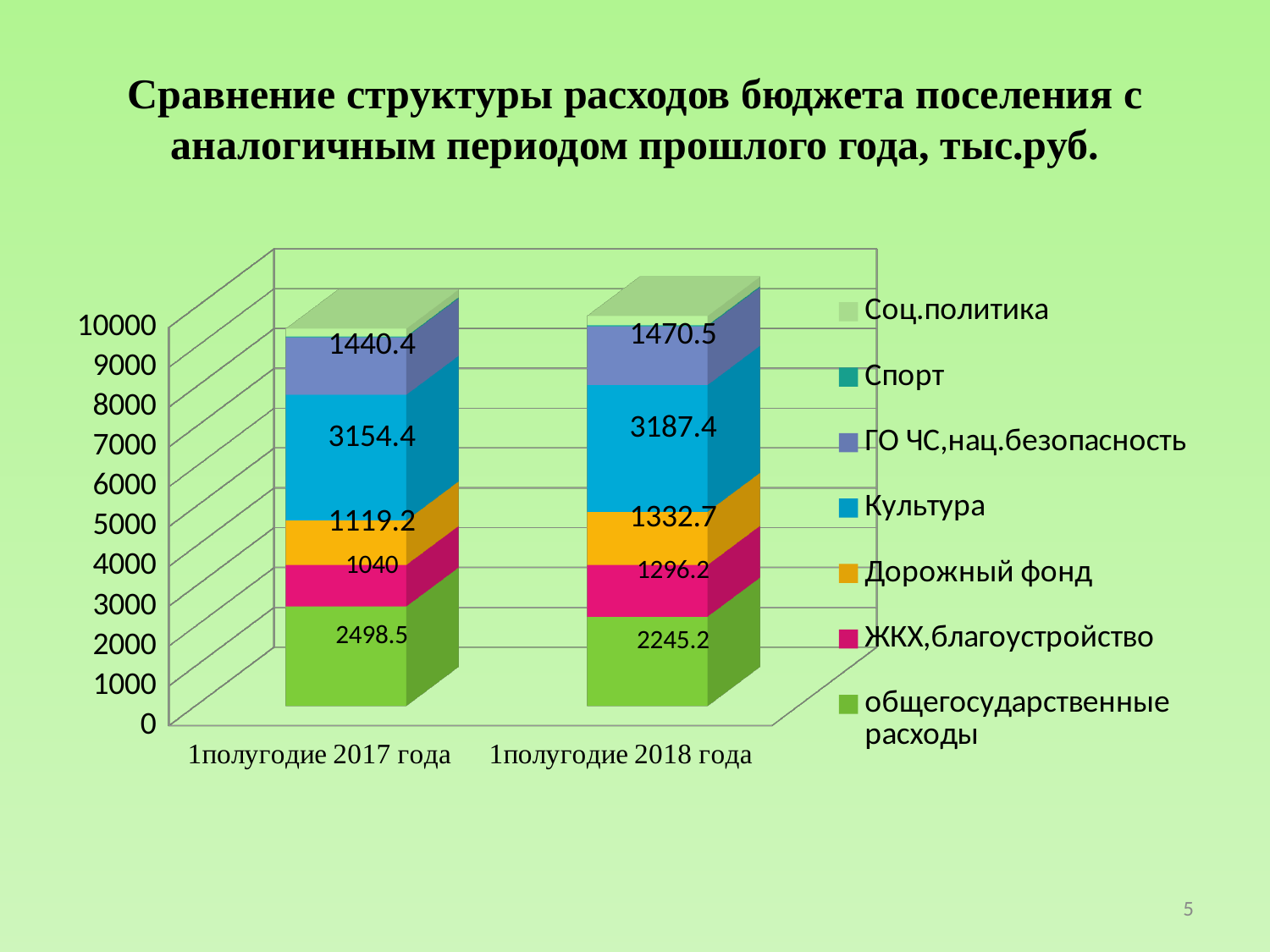
What is the difference between the Дорожный фонд values for 1полугодие 2018 года and 1полугодие 2017 года? 213.5 What kind of chart is shown on the slide? Stacked bar chart What is the value for Культура in 1полугодие 2018 года? 3187.4 What is the value for Дорожный фонд in 1полугодие 2017 года? 1119.2 What is the difference between the ЖКХ,благоустройство values for 1полугодие 2018 года and 1полугодие 2017 года? 256.2 What is the value for общегосударственные расходы in 1полугодие 2017 года? 2498.5 How many series does the legend list? 7 What is the value for ЖКХ,благоустройство in 1полугодие 2018 года? 1296.2 Which period has the larger value for общегосударственные расходы, 1полугодие 2017 года or 1полугодие 2018 года? 1полугодие 2017 года What is the value for Культура in 1полугодие 2017 года? 3154.4 What is the value for ГО ЧС,нац.безопасность in 1полугодие 2018 года? 1470.5 How many categories are shown on the x axis? 2